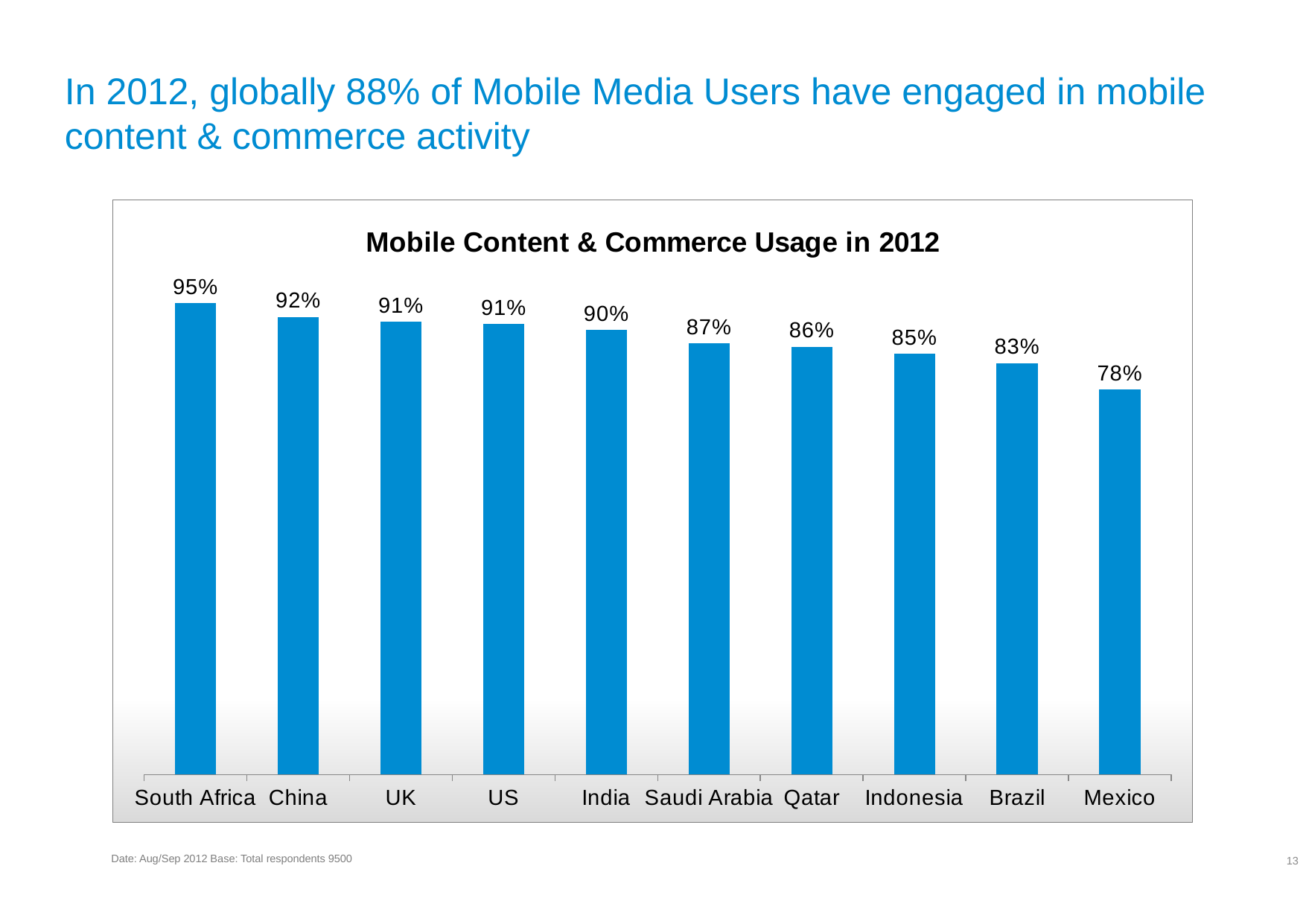
What is the mobile content & commerce usage value for South Africa? 95% What is the difference between the values for China and Brazil? 9% What is the title of the chart? Mobile Content & Commerce Usage in 2012 Which country has the lowest mobile content & commerce usage? Mexico Do the values rise or fall from left to right across the chart? Fall Which has a higher value, India or Qatar? India Which country has the highest mobile content & commerce usage? South Africa What is the difference between the values for South Africa and Mexico? 17% What is the value shown for Mexico? 78% What is the value shown for Saudi Arabia? 87% How many countries are shown in the chart? 10 What type of chart is shown on the slide? Bar chart